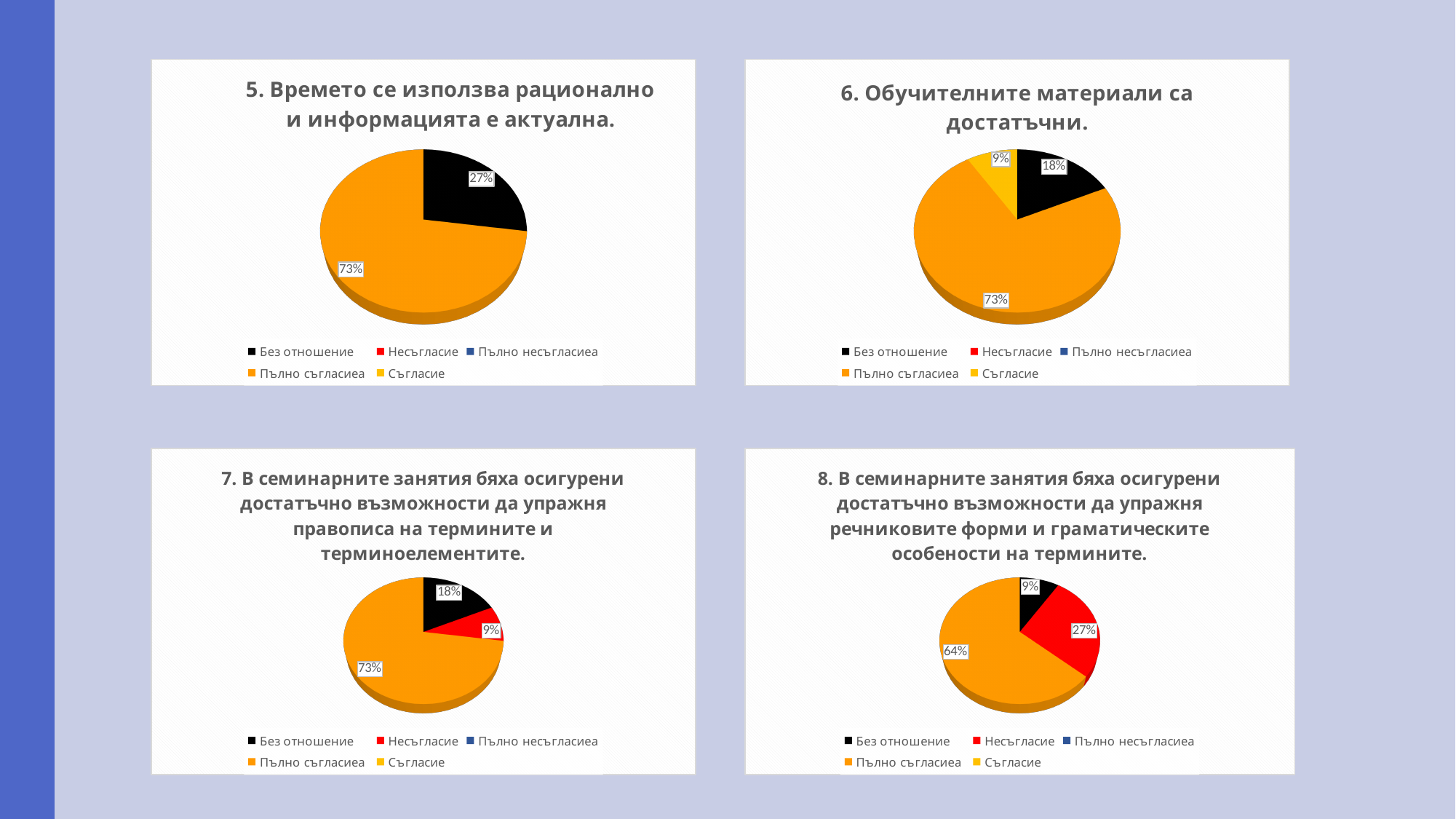
In the bottom-right chart (8. В семинарните занятия...), which is larger, the Несъгласие slice or the Без отношение slice? Несъгласие How many entries does the legend of the bottom-left chart (7. В семинарните занятия...) list? 5 In the top-left chart (5. Времето се използва рационално и информацията е актуална.), what share does the Без отношение slice have? 27% In the bottom-left chart (7. В семинарните занятия...), what share does the Несъгласие slice have? 9% In the bottom-left chart (7. В семинарните занятия...), which category has the smallest slice? Несъгласие In the bottom-right chart (8. В семинарните занятия...), what is the difference between the Пълно съгласиеа and Несъгласие slices? 37% In the bottom-right chart (8. В семинарните занятия...), what share does the Пълно съгласиеа slice have? 64% In the top-right chart (6. Обучителните материали са достатъчни.), what share does the Съгласие slice have? 9% In the top-right chart (6. Обучителните материали са достатъчни.), what is the difference between the Без отношение and Съгласие slices? 9% In the top-left chart (5. Времето се използва рационално и информацията е актуална.), what share does the Пълно съгласиеа slice have? 73% In the top-right chart (6. Обучителните материали са достатъчни.), which category has the largest slice? Пълно съгласиеа What type of chart is used in the top-left chart (5. Времето се използва рационално и информацията е актуална.)? Pie chart